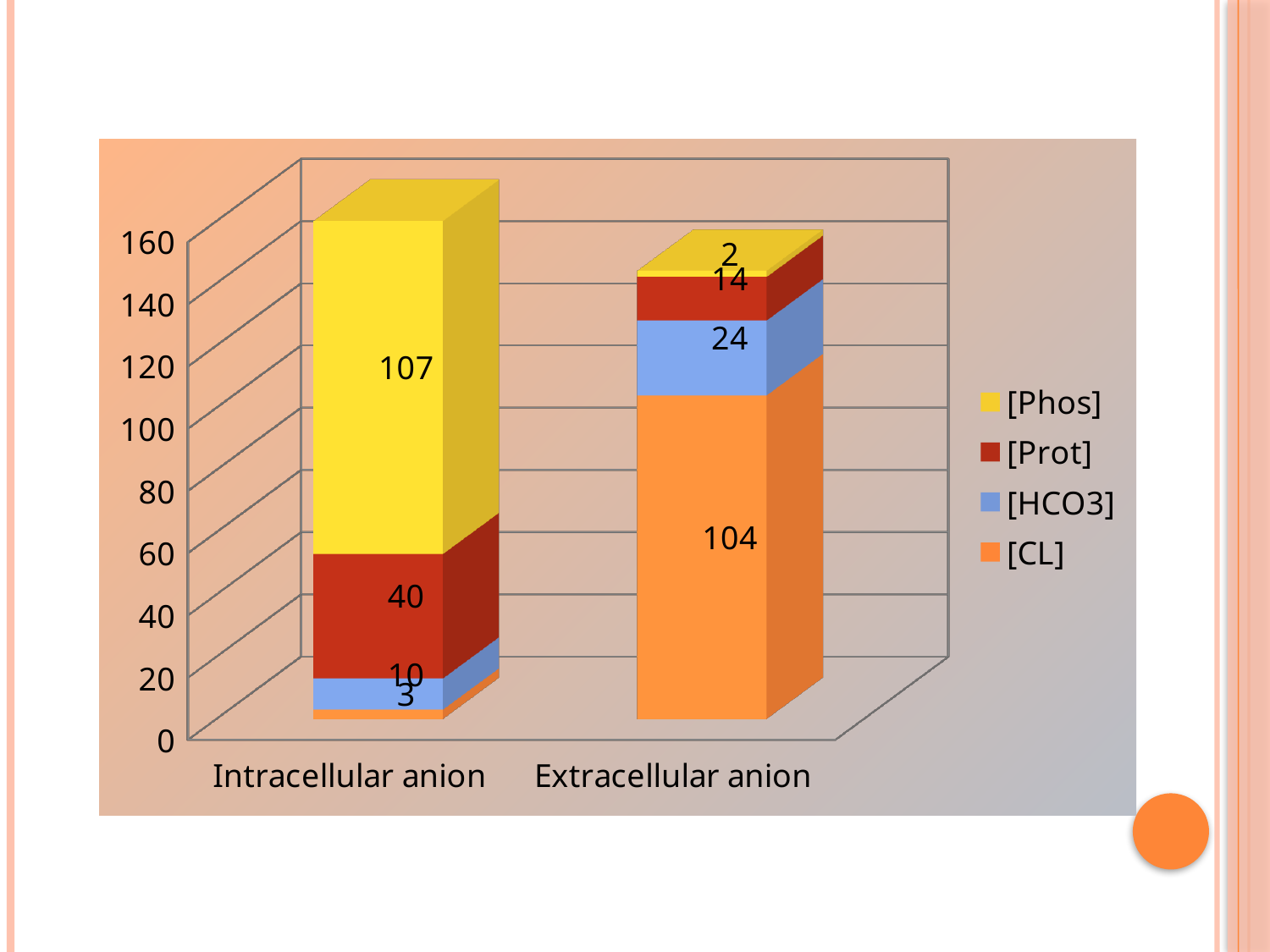
Which is larger, the [HCO3] value for Intracellular anion or for Extracellular anion? Extracellular anion Which series has the largest value in the Intracellular anion bar? [Phos] What is the [HCO3] value for Extracellular anion? 24 What kind of chart is shown on the slide? Stacked bar chart What is the [CL] value for Extracellular anion? 104 What is the [Phos] value for Extracellular anion? 2 How many series does the legend list? 4 Which series has the smallest value in the Extracellular anion bar? [Phos] What is the [Phos] value for Intracellular anion? 107 What is the [Prot] value for Intracellular anion? 40 What is the total of the Extracellular anion stacked bar? 144 What is the difference between the [Prot] values for Intracellular anion and Extracellular anion? 26